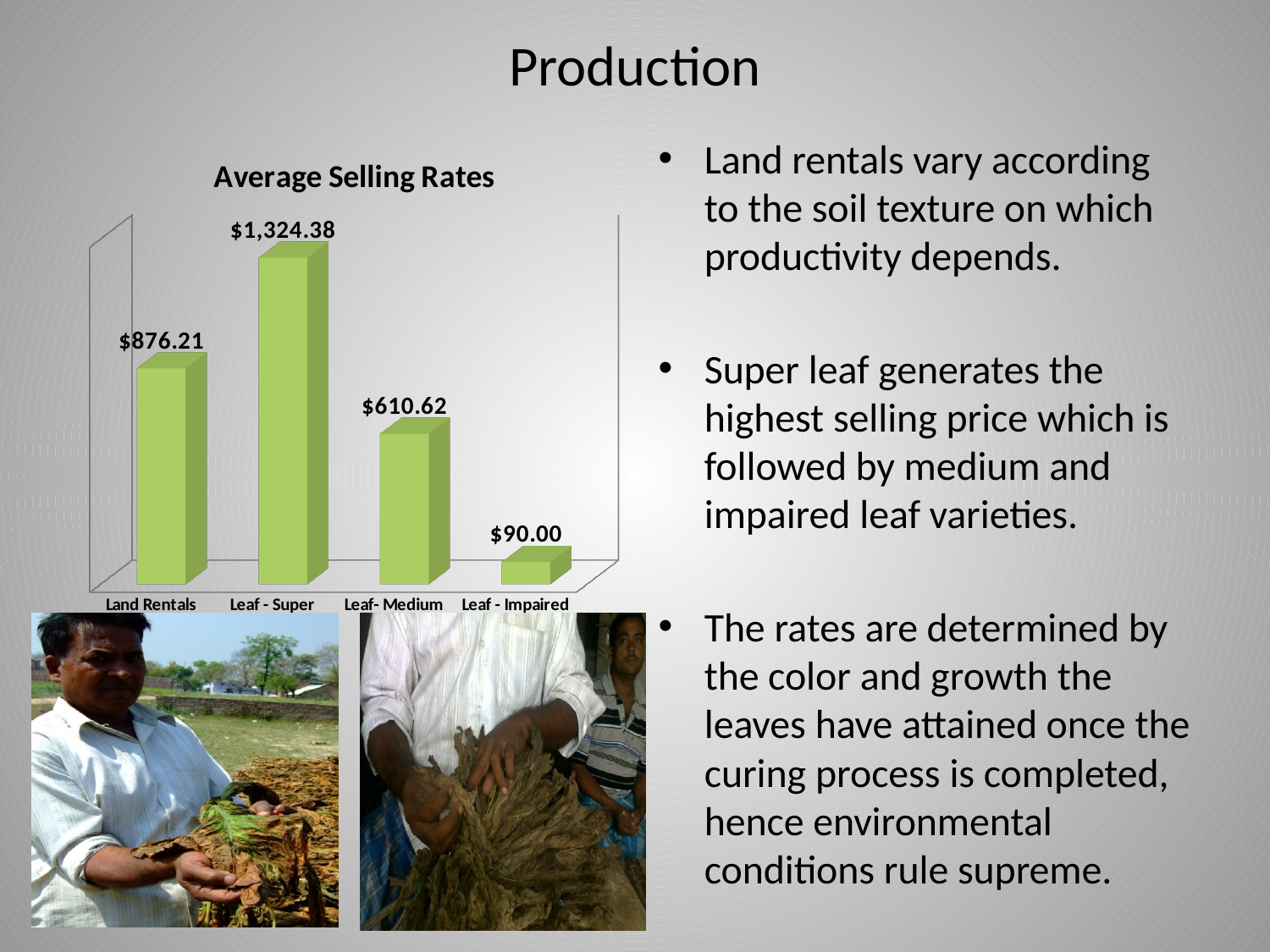
What is the difference between the values for Leaf - Super and Land Rentals in the Average Selling Rates chart? $448.17 Which is larger in the Average Selling Rates chart, Land Rentals or Leaf- Medium? Land Rentals What is the value for Leaf - Impaired in the Average Selling Rates chart? $90.00 What is the title of the chart on the slide? Average Selling Rates What is the value for Leaf- Medium in the Average Selling Rates chart? $610.62 How many categories are shown in the Average Selling Rates chart? 4 What is the value for Leaf - Super in the Average Selling Rates chart? $1,324.38 What kind of chart is the Average Selling Rates chart? Bar chart Which category has the lowest value in the Average Selling Rates chart? Leaf - Impaired What is the difference between the values for Leaf- Medium and Leaf - Impaired in the Average Selling Rates chart? $520.62 Which category has the highest value in the Average Selling Rates chart? Leaf - Super What is the value for Land Rentals in the Average Selling Rates chart? $876.21